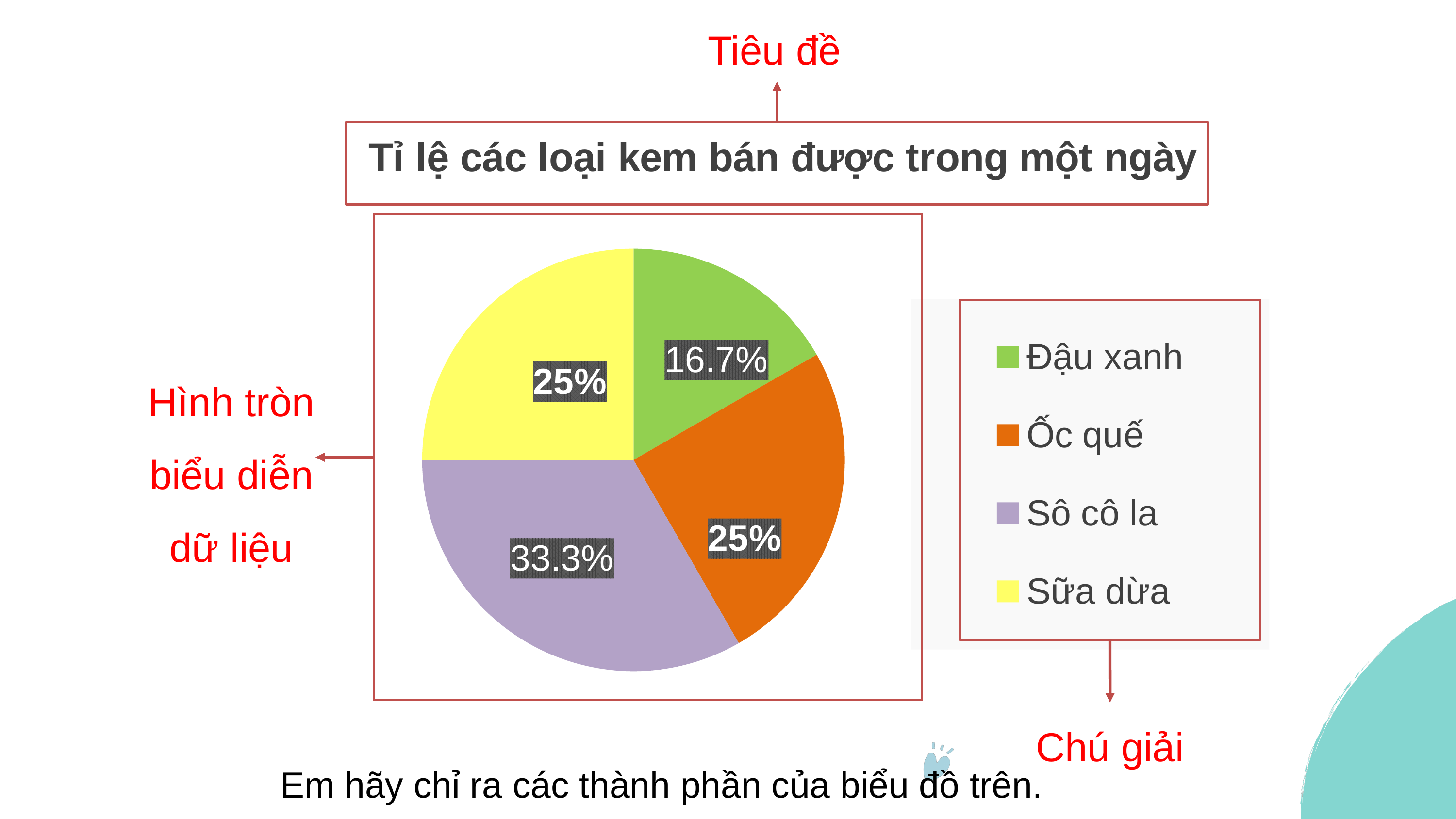
Which ice cream type has the largest share of the pie? Sô cô la What kind of chart is shown on the slide? Pie chart What percentage of the pie is Ốc quế? 25% Which has a larger share, Ốc quế or Đậu xanh? Ốc quế What is the title of the chart? Tỉ lệ các loại kem bán được trong một ngày What is the difference between the shares of Sô cô la and Đậu xanh? 16.6% What percentage of the pie is Đậu xanh? 16.7% Which colour represents Sữa dừa in the legend? Yellow How many categories does the pie chart have? 4 What percentage of the pie is Sữa dừa? 25% What percentage of the pie is Sô cô la? 33.3% Which ice cream type has the smallest share of the pie? Đậu xanh